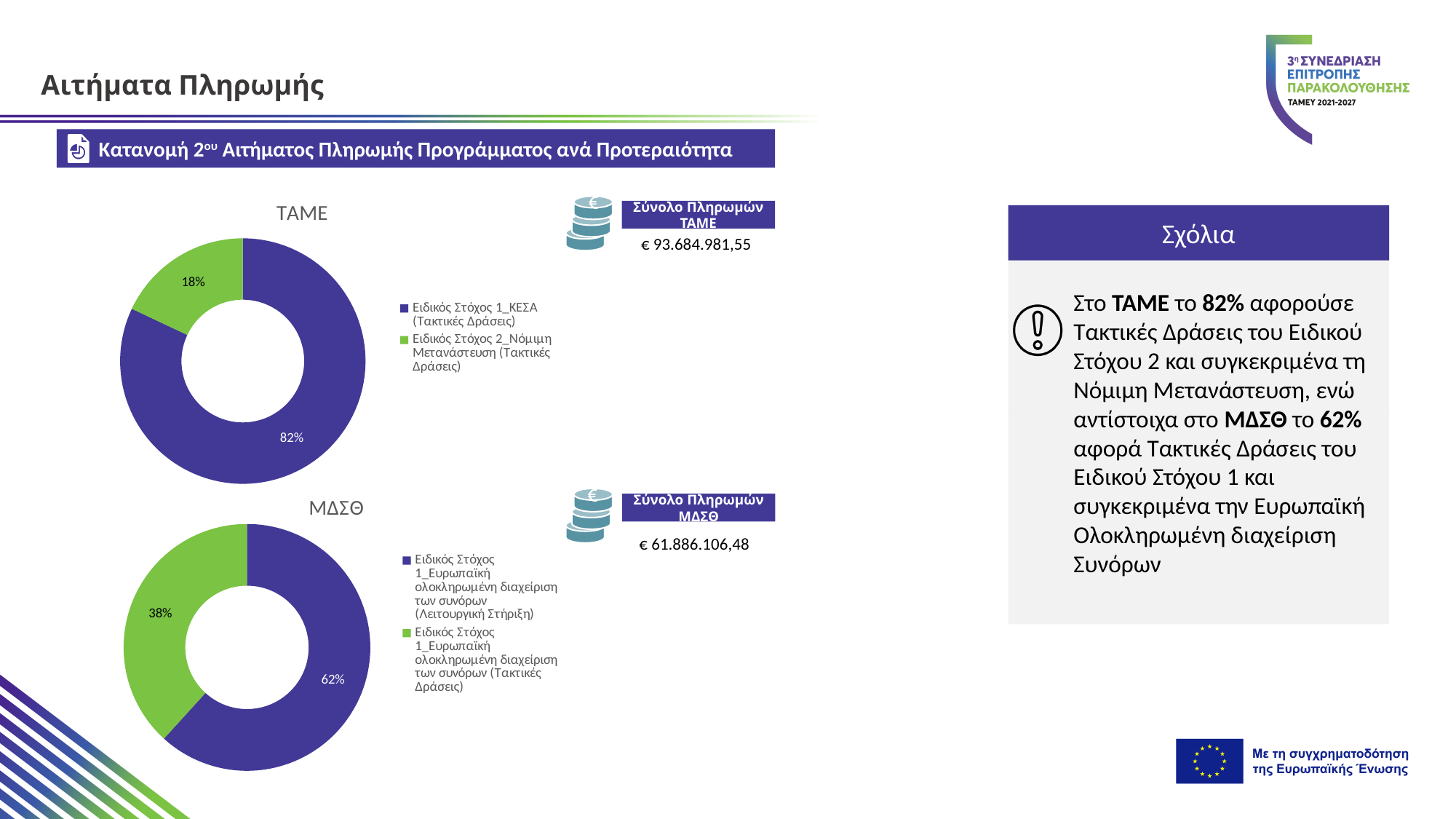
How many slices does the ΤΑΜΕ chart have? 2 In the ΤΑΜΕ chart, what is the value of the largest slice? 82% What total payment amount is shown next to the ΜΔΣΘ chart (Σύνολο Πληρωμών ΜΔΣΘ)? € 61.886.106,48 In the ΤΑΜΕ chart, what is the difference between the two slices? 64 percentage points In the ΜΔΣΘ chart, what share does the green slice represent? 38% In the ΜΔΣΘ chart, what is the difference between the purple and green slices? 24 percentage points Which green slice is larger: the one in the ΤΑΜΕ chart or the one in the ΜΔΣΘ chart? The one in the ΜΔΣΘ chart What kind of chart is used for ΤΑΜΕ on the slide? A doughnut (pie) chart What total payment amount is shown next to the ΤΑΜΕ chart (Σύνολο Πληρωμών ΤΑΜΕ)? € 93.684.981,55 In the ΜΔΣΘ chart, what share does the purple slice represent? 62% How many entries does the legend of the ΜΔΣΘ chart list? 2 In the ΤΑΜΕ chart, what is the value of the smallest slice? 18%